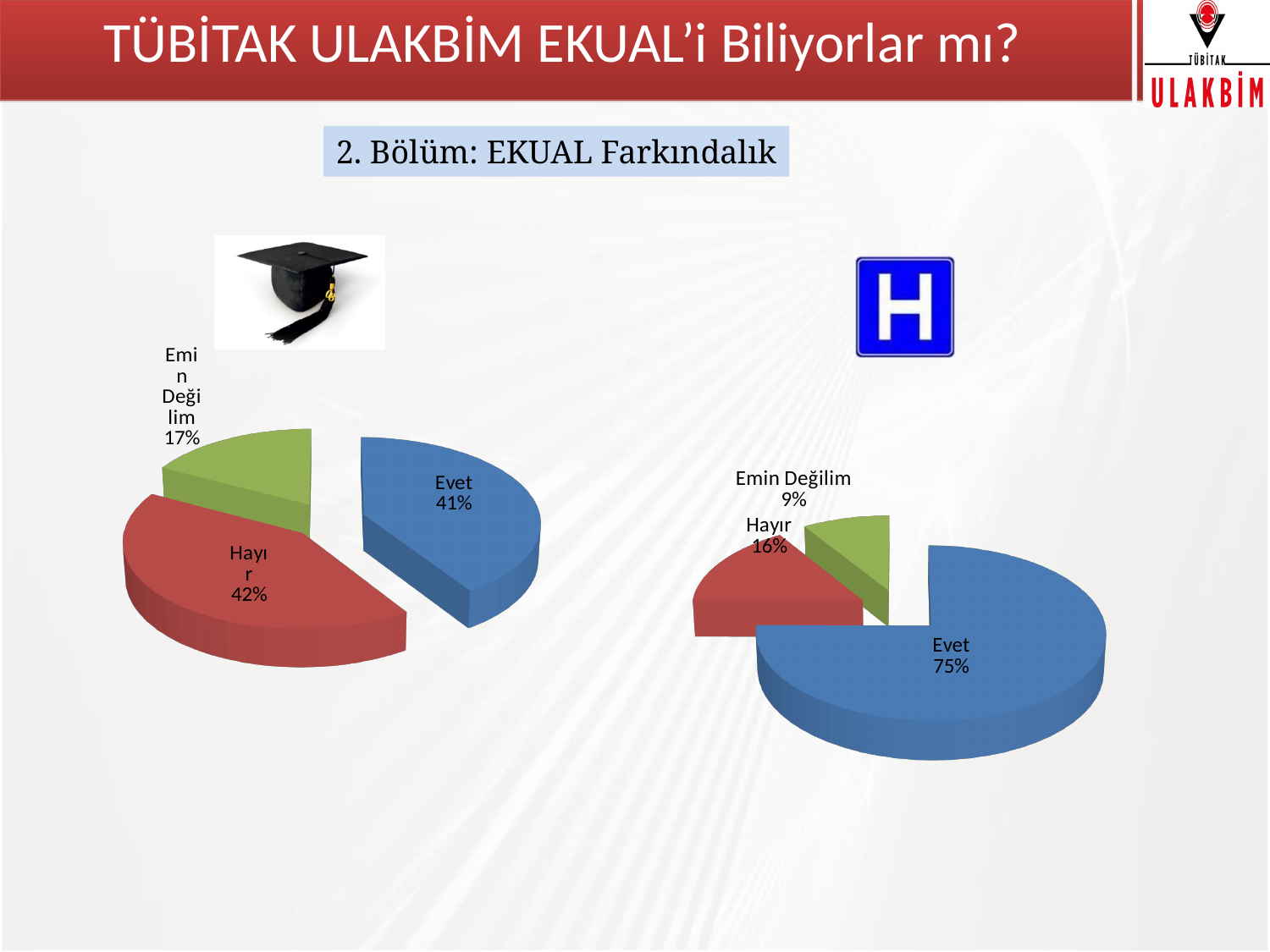
On the left pie chart, what is the share for Emin Değilim? 17% On the right pie chart, which category has the largest share? Evet On the left pie chart, what is the difference between the Hayır and Emin Değilim shares? 25% On the right pie chart, what is the share for Emin Değilim? 9% On the right pie chart, what is the share for Hayır? 16% On the left pie chart, what is the share for Hayır? 42% On the left pie chart, what is the share for Evet? 41% On the right pie chart, what is the difference between the Evet and Hayır shares? 59% How many slices does the right pie chart have? 3 On the left pie chart, which category has the smallest share? Emin Değilim What type of chart is shown on the left side of the slide? Pie chart On the right pie chart, what is the share for Evet? 75%